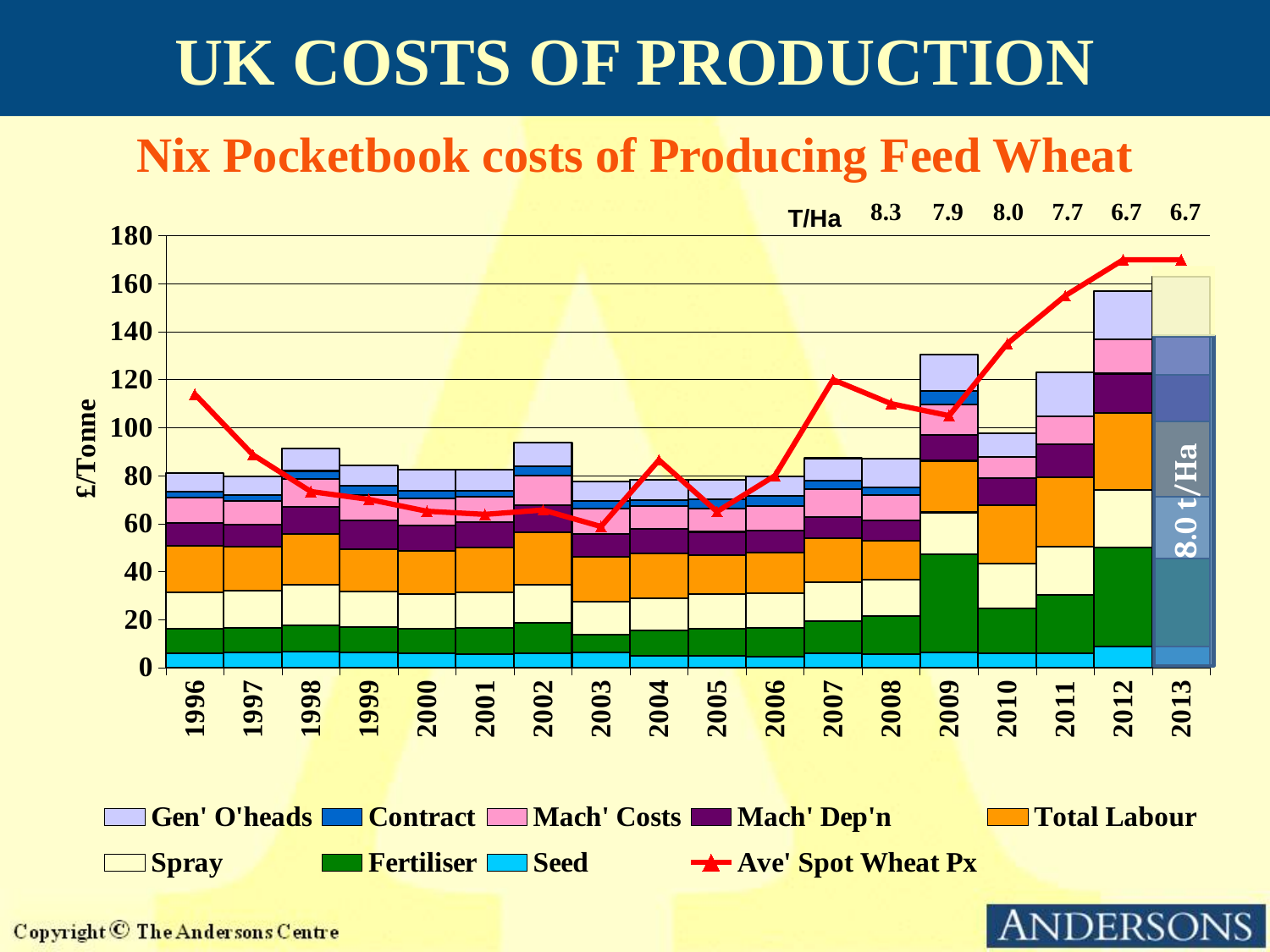
Is the total cost bar for 2012 greater or less than 140 £/Tonne? greater Which is larger, the total cost bar for 2009 or for 2003? 2009 How many series does the legend list? 9 What kind of chart is shown on the slide? Stacked bar chart with a line What is the T/Ha figure printed above the 2008 bar? 8.3 Is the total cost bar for 2003 greater or less than 80 £/Tonne? less How many years are shown along the x axis? 18 Does the Ave' Spot Wheat Px line rise or fall from 2009 to 2013? rise Is the Ave' Spot Wheat Px value for 2013 greater or less than 160? greater What is the T/Ha figure printed above the 2012 bar? 6.7 Which series is shown as a red line with triangle markers? Ave' Spot Wheat Px What is the subtitle of the chart? Nix Pocketbook costs of Producing Feed Wheat